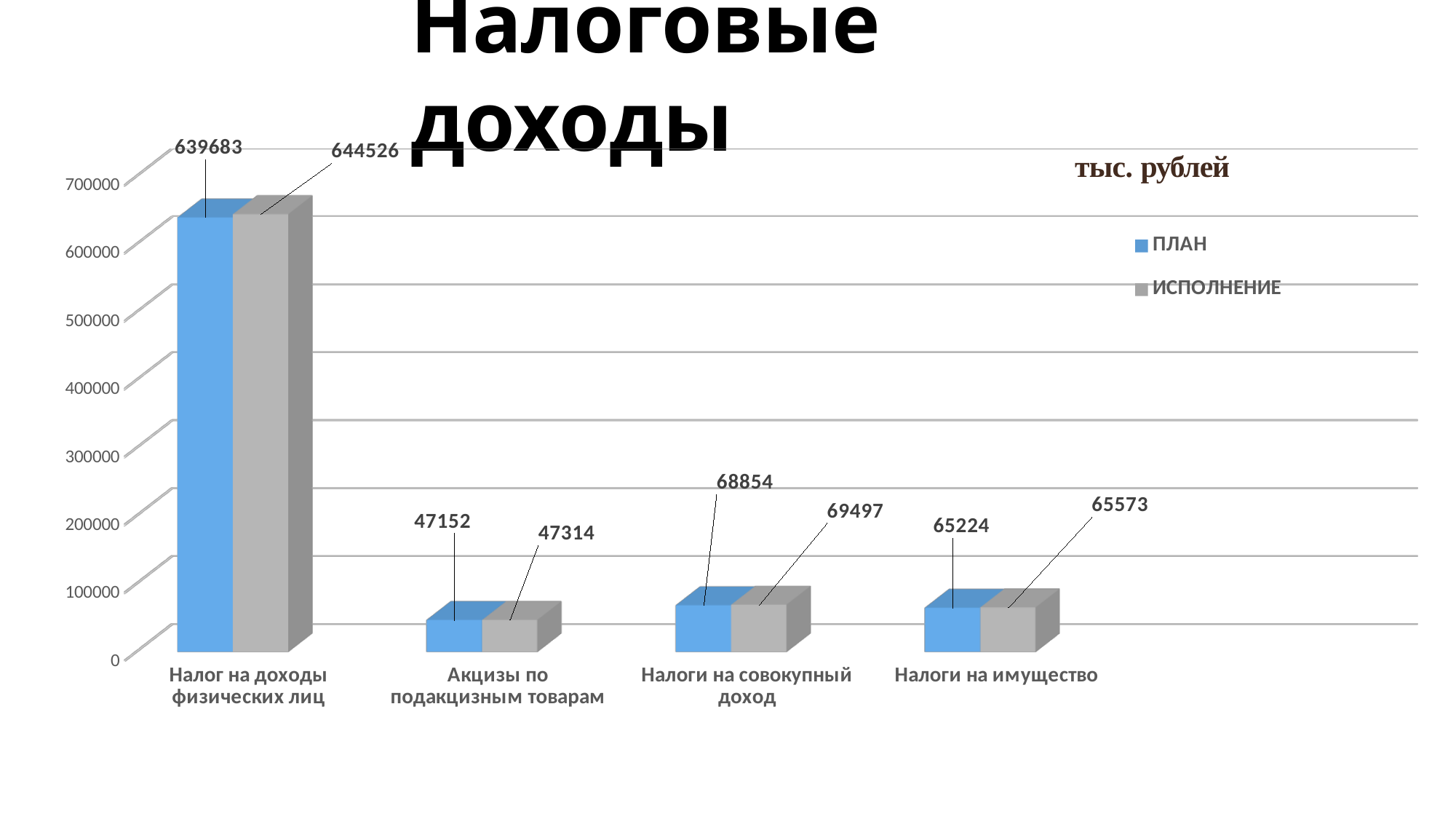
Which category has the lowest ПЛАН value? Акцизы по подакцизным товарам How many series does the legend list? 2 Which is larger for Налоги на совокупный доход: ПЛАН or ИСПОЛНЕНИЕ? ИСПОЛНЕНИЕ What is the ИСПОЛНЕНИЕ value for Акцизы по подакцизным товарам? 47314 What is the ПЛАН value for Налог на доходы физических лиц? 639683 What is the ПЛАН value for Налоги на совокупный доход? 68854 What is the difference between ИСПОЛНЕНИЕ and ПЛАН for Налог на доходы физических лиц? 4843 Which category has the highest ИСПОЛНЕНИЕ value? Налог на доходы физических лиц How many categories are shown on the x axis? 4 What is the ИСПОЛНЕНИЕ value for Налоги на имущество? 65573 Is the ПЛАН value for Налог на доходы физических лиц greater or less than 600000? greater What unit of measurement is indicated on the chart? тыс. рублей